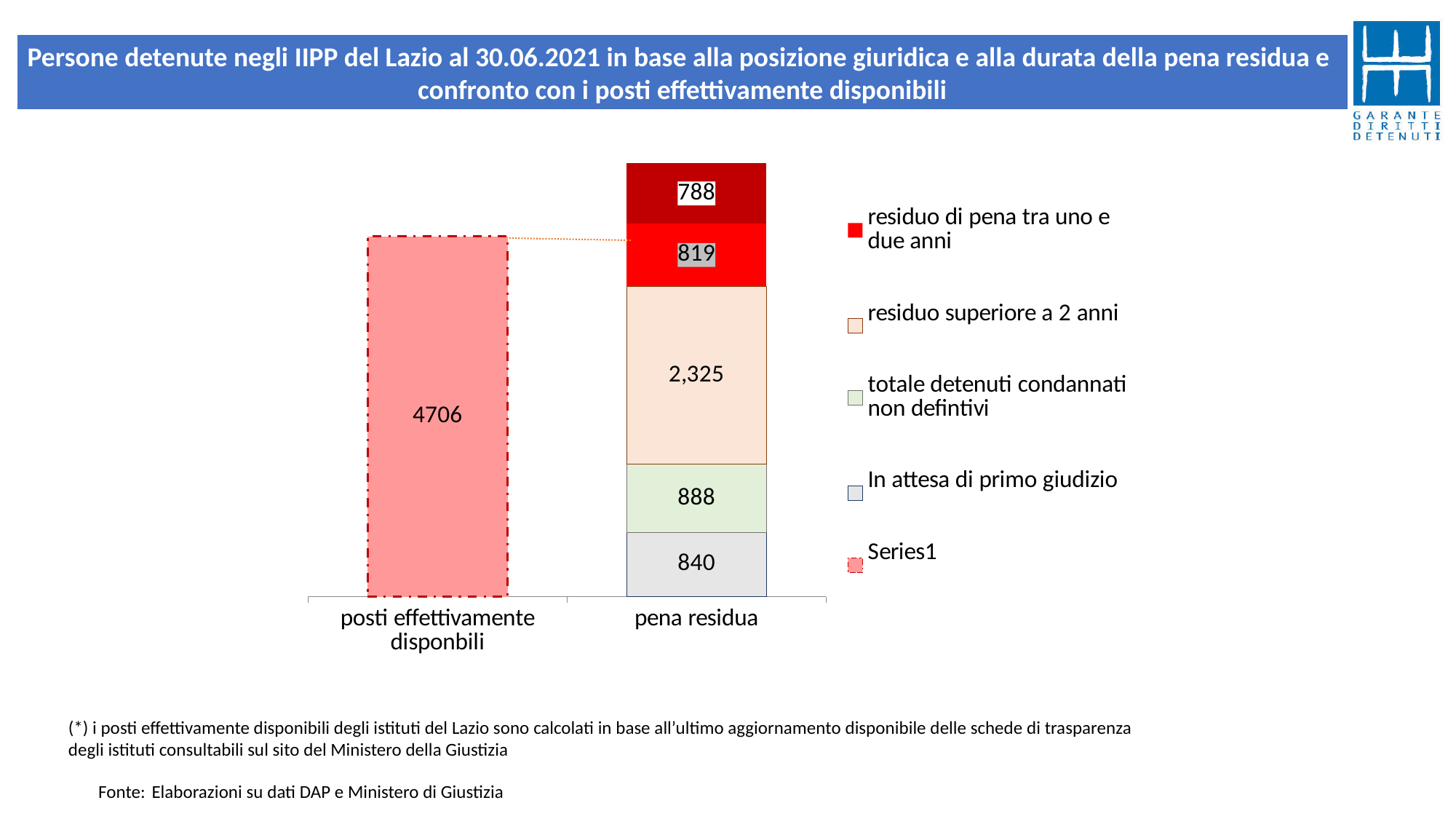
What is the value shown for 'posti effettivamente disponbili'? 4706 In the 'pena residua' bar, what is the value for 'residuo di pena tra uno e due anni'? 819 What is the total of the stacked 'pena residua' bar? 5660 What kind of chart is shown on the slide? Stacked bar chart In the 'pena residua' bar, what is the value for 'totale detenuti condannati non definitivi'? 888 In the 'pena residua' bar, what is the value for 'residuo superiore a 2 anni'? 2,325 How many entries does the legend list? 5 How many categories are shown on the x axis? 2 What is the difference between the 'residuo superiore a 2 anni' segment and the 'totale detenuti condannati non definitivi' segment? 1437 In the 'pena residua' bar, what is the value for 'In attesa di primo giudizio'? 840 Which segment of the 'pena residua' bar is the largest? residuo superiore a 2 anni Which bar is taller, 'posti effettivamente disponbili' or 'pena residua'? pena residua